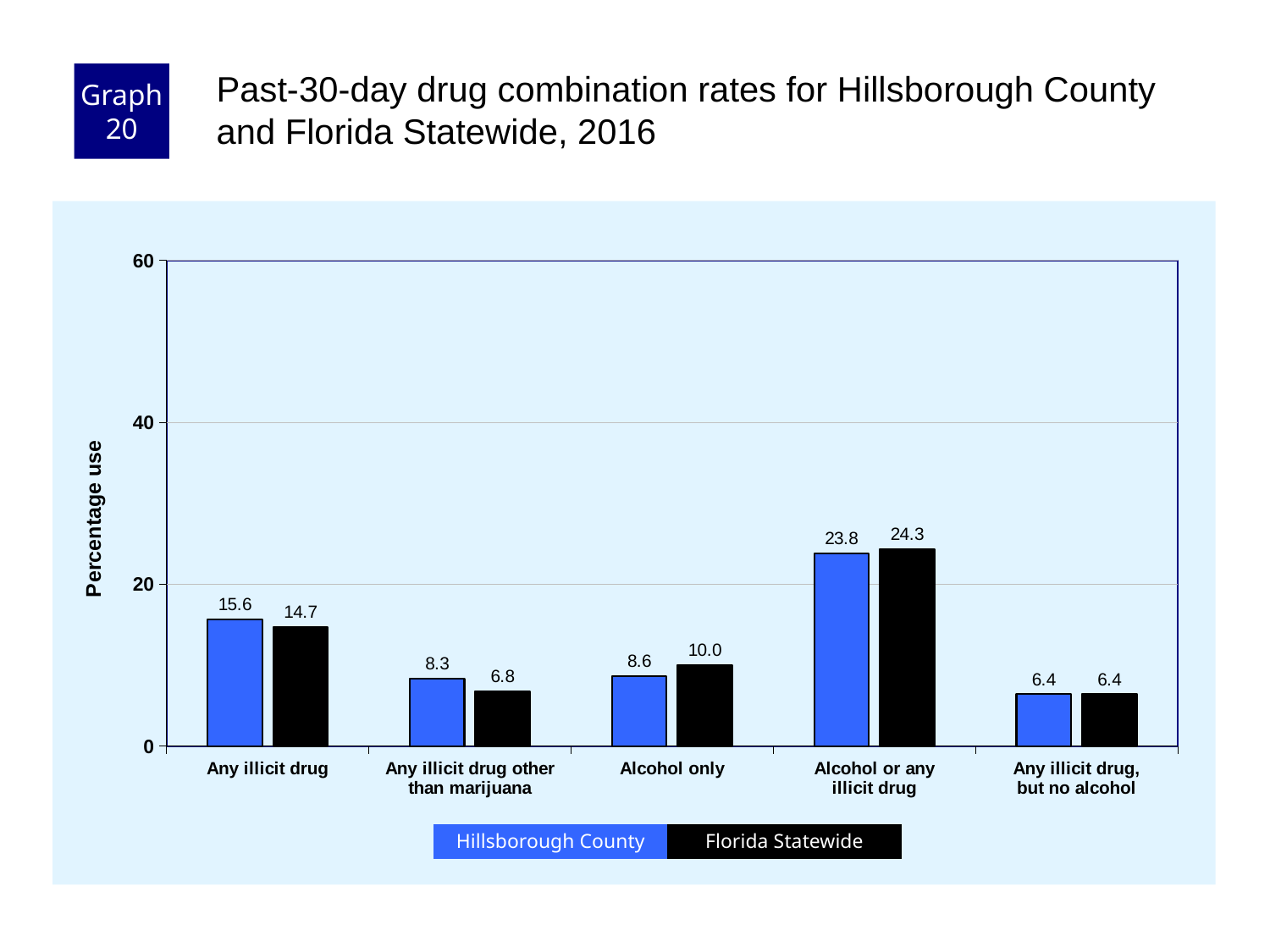
Which category has the lowest Florida Statewide value? Any illicit drug, but no alcohol What kind of chart is shown? bar chart For Any illicit drug other than marijuana, which is larger: Hillsborough County or Florida Statewide? Hillsborough County How many categories are shown on the x axis? 5 How many series does the legend list? 2 What is the Florida Statewide value for Alcohol only? 10.0 Is the Florida Statewide value for Alcohol or any illicit drug greater or less than 20? greater What is the label of the y axis? Percentage use What is the Hillsborough County value for Any illicit drug? 15.6 Which category has the highest Hillsborough County value? Alcohol or any illicit drug What is the Florida Statewide value for Any illicit drug other than marijuana? 6.8 What is the difference between the Florida Statewide and Hillsborough County values for Alcohol or any illicit drug? 0.5